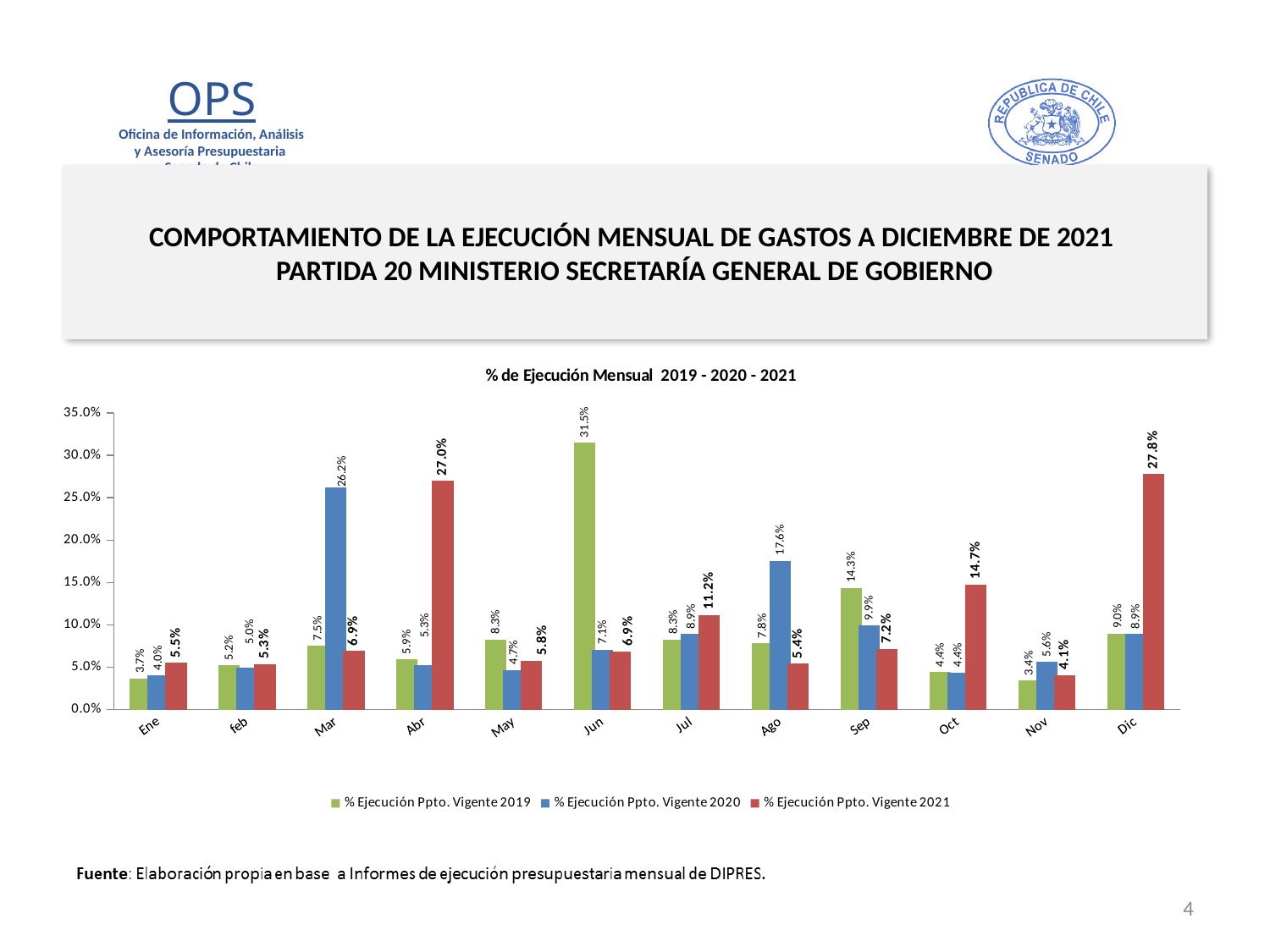
What kind of chart is shown on the slide? Bar chart What is the value for Sep in the % Ejecución Ppto. Vigente 2019 series? 14.3% Which month has the lowest value in the % Ejecución Ppto. Vigente 2021 series? Nov What is the value for Dic in the % Ejecución Ppto. Vigente 2021 series? 27.8% What is the difference between the 2021 and 2019 values for Abr? 21.1% How many series does the legend list? 3 Which is larger for Ago: the 2020 value or the 2021 value? 2020 Which month has the highest value in the % Ejecución Ppto. Vigente 2019 series? Jun What is the value for Mar in the % Ejecución Ppto. Vigente 2020 series? 26.2% Is the value for Jun in the 2019 series greater or less than 30.0%? greater What is the title of the chart? % de Ejecución Mensual 2019 - 2020 - 2021 How many months are shown on the x axis? 12